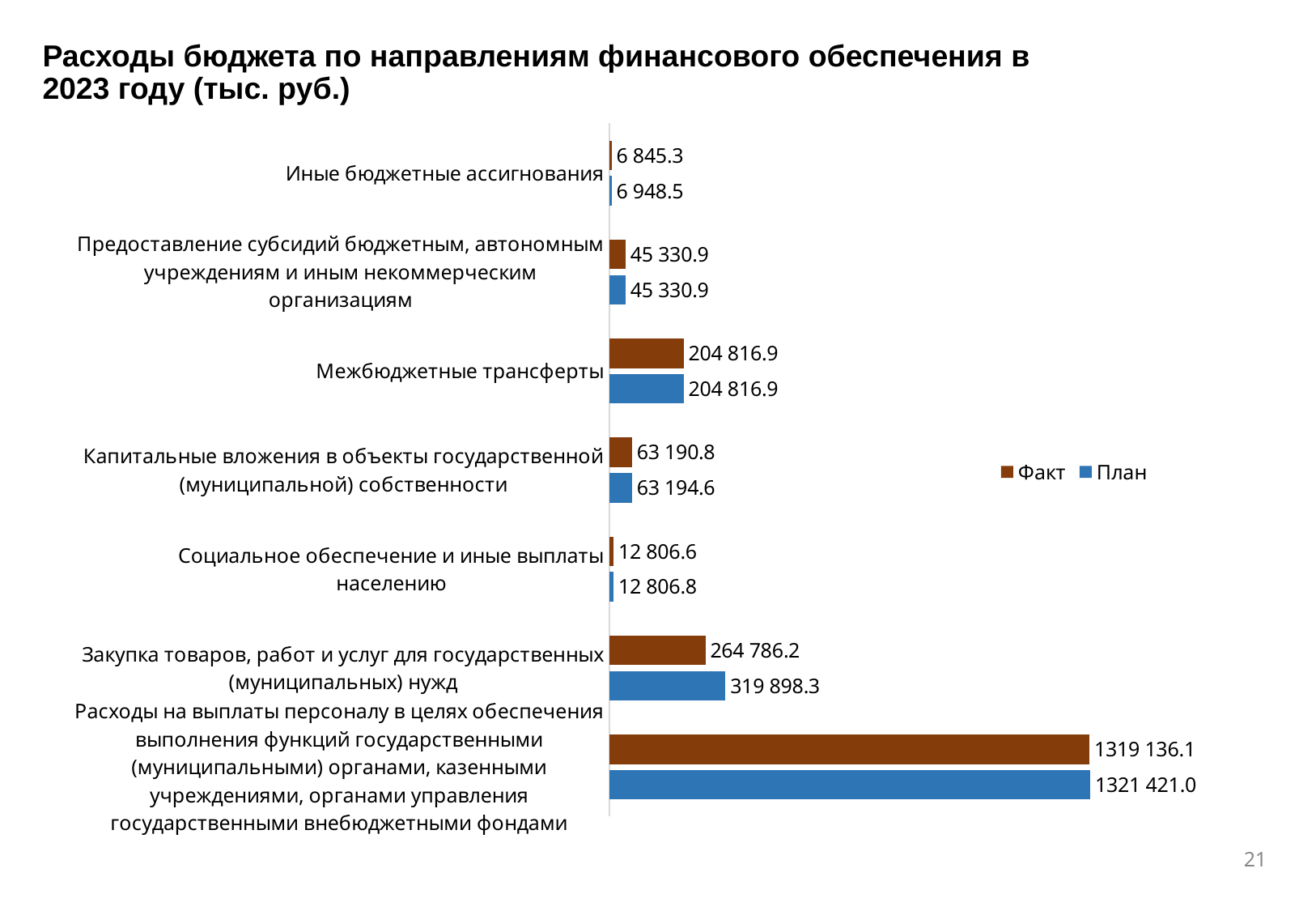
Which series is shown in brown in the legend? Факт What is the Факт value for Иные бюджетные ассигнования? 6 845.3 What is the План value for Закупка товаров, работ и услуг для государственных (муниципальных) нужд? 319 898.3 How many series does the legend list? 2 What is the Факт value for Межбюджетные трансферты? 204 816.9 Which is larger for Закупка товаров, работ и услуг для государственных (муниципальных) нужд: the Факт value or the План value? План What is the План value for Капитальные вложения в объекты государственной (муниципальной) собственности? 63 194.6 What type of chart is shown on the slide? bar chart Which category has the highest План value? Расходы на выплаты персоналу в целях обеспечения выполнения функций государственными (муниципальными) органами, казенными учреждениями, органами управления государственными внебюджетными фондами How many categories are shown in the chart? 7 What is the difference between the План and Факт values for Закупка товаров, работ и услуг для государственных (муниципальных) нужд? 55 112.1 Which category has the lowest Факт value? Иные бюджетные ассигнования